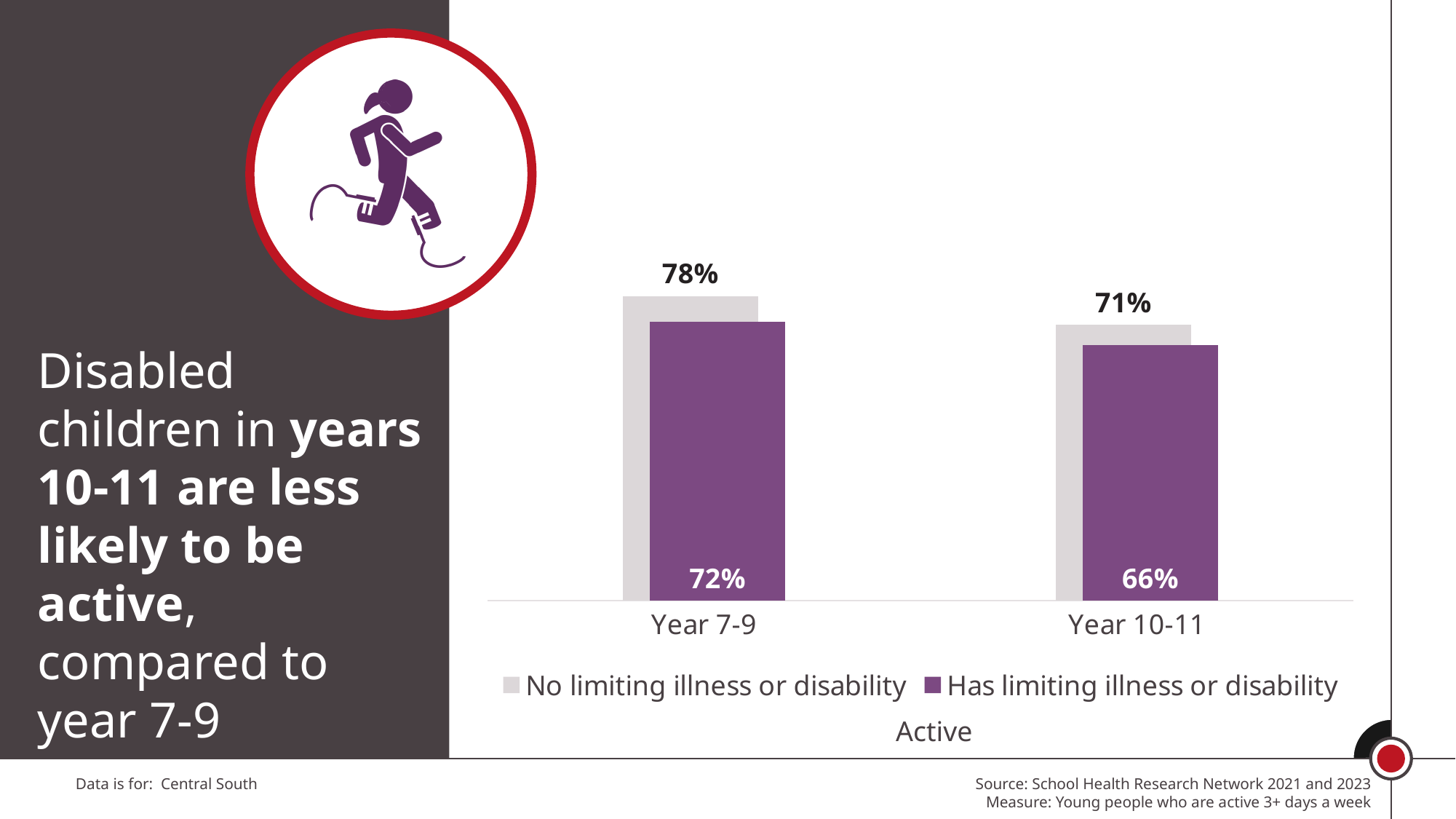
How many series does the legend list? 2 What is the difference between the 'No limiting illness or disability' and 'Has limiting illness or disability' values for Year 7-9? 6 percentage points What percentage of Year 10-11 pupils who have a limiting illness or disability are active? 66% What percentage of Year 7-9 pupils who have a limiting illness or disability are active? 72% What percentage of Year 7-9 pupils with no limiting illness or disability are active? 78% What is the difference between the 'No limiting illness or disability' and 'Has limiting illness or disability' values for Year 10-11? 5 percentage points Which bar shows the lowest value on the chart? Has limiting illness or disability, Year 10-11 What percentage of Year 10-11 pupils with no limiting illness or disability are active? 71% Which year group has the higher value for pupils who have a limiting illness or disability? Year 7-9 How many year-group categories are shown on the x axis? 2 What type of chart is shown on the slide? Bar chart Which series is shown in purple in the legend? Has limiting illness or disability